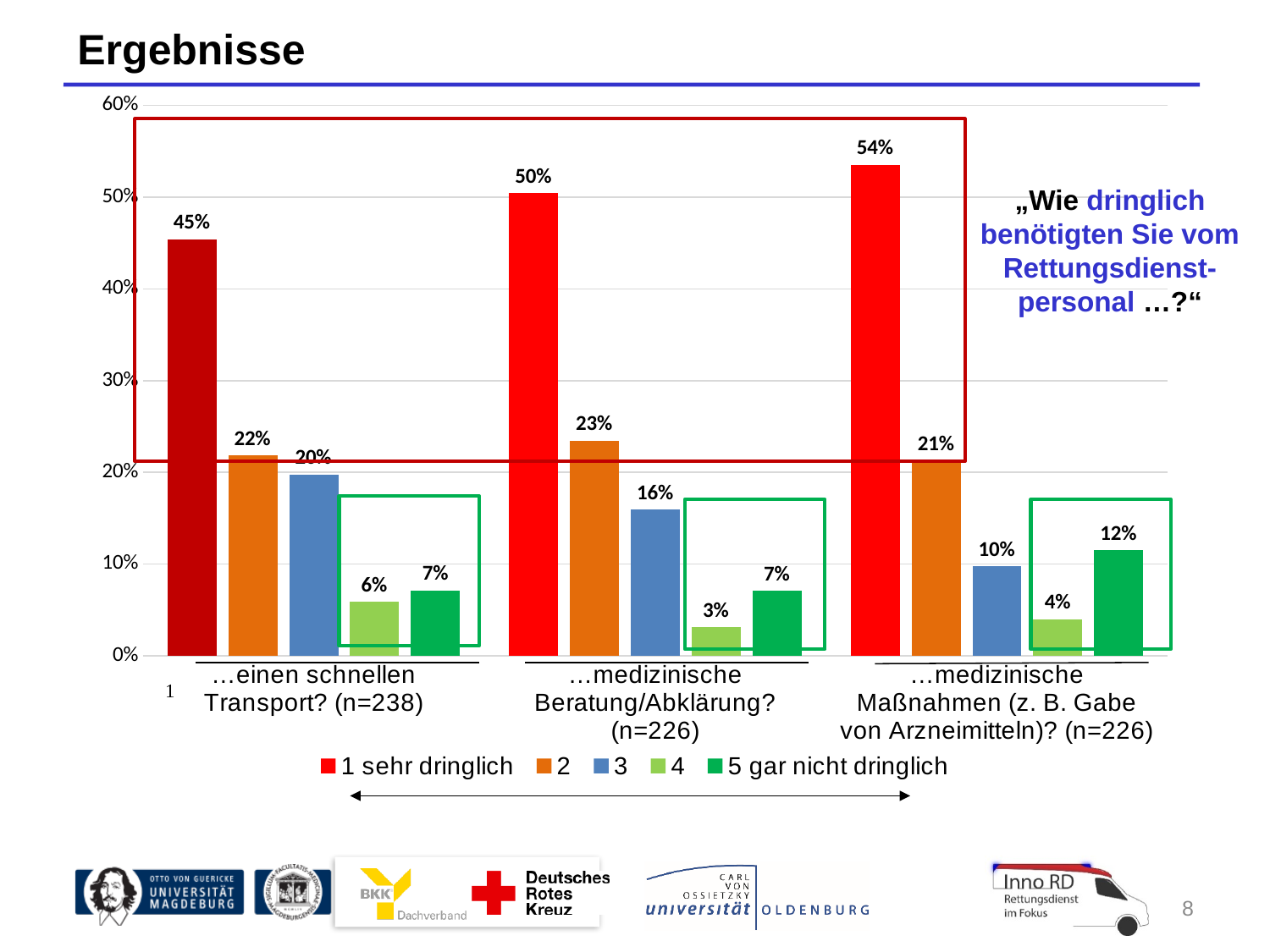
Which is larger: the value for series "2" in "…medizinische Beratung/Abklärung? (n=226)" or in "…medizinische Maßnahmen (z. B. Gabe von Arzneimitteln)? (n=226)"? …medizinische Beratung/Abklärung? (n=226) What is the value for series "4" in the category "…medizinische Beratung/Abklärung? (n=226)"? 3% What is the value for "5 gar nicht dringlich" in the category "…medizinische Maßnahmen (z. B. Gabe von Arzneimitteln)? (n=226)"? 12% What is the difference between the "1 sehr dringlich" values for "…medizinische Beratung/Abklärung? (n=226)" and "…einen schnellen Transport? (n=238)"? 5% Which category has the highest value for "1 sehr dringlich"? …medizinische Maßnahmen (z. B. Gabe von Arzneimitteln)? (n=226) Is the value for "1 sehr dringlich" in "…medizinische Beratung/Abklärung? (n=226)" greater or less than 40%? greater What is the value for "1 sehr dringlich" in the category "…medizinische Maßnahmen (z. B. Gabe von Arzneimitteln)? (n=226)"? 54% What is the value for "1 sehr dringlich" in the category "…einen schnellen Transport? (n=238)"? 45% How many categories are shown on the x axis of the chart? 3 How many series does the legend list? 5 What kind of chart is shown on the slide? bar chart Which category has the lowest value for series "3"? …medizinische Maßnahmen (z. B. Gabe von Arzneimitteln)? (n=226)